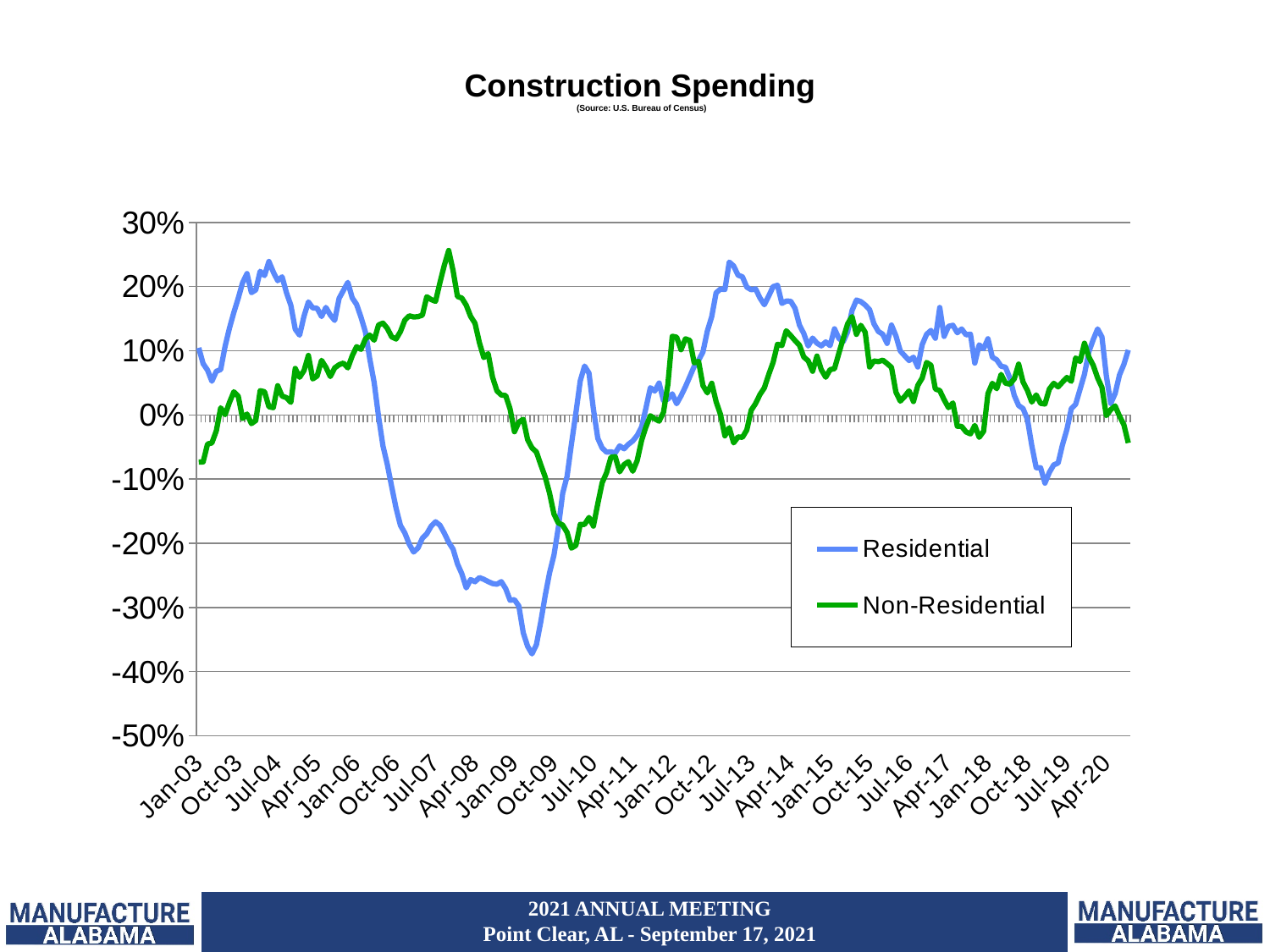
Is the value for Residential at Jul-07 greater or less than -10%? less At Jul-13, which series has the higher value, Residential or Non-Residential? Residential Which series reaches the lowest value on the chart? Residential Is the value for Non-Residential at Jul-07 greater or less than 10%? greater At Jul-07, which series has the higher value, Residential or Non-Residential? Non-Residential Is the lowest value of the Residential series greater or less than -30%? less What kind of chart is shown on the slide? line chart Which series is drawn in green? Non-Residential What is the title of the chart? Construction Spending Does the Residential series rise or fall between Jan-06 and Jul-09? fall How many series does the legend list? 2